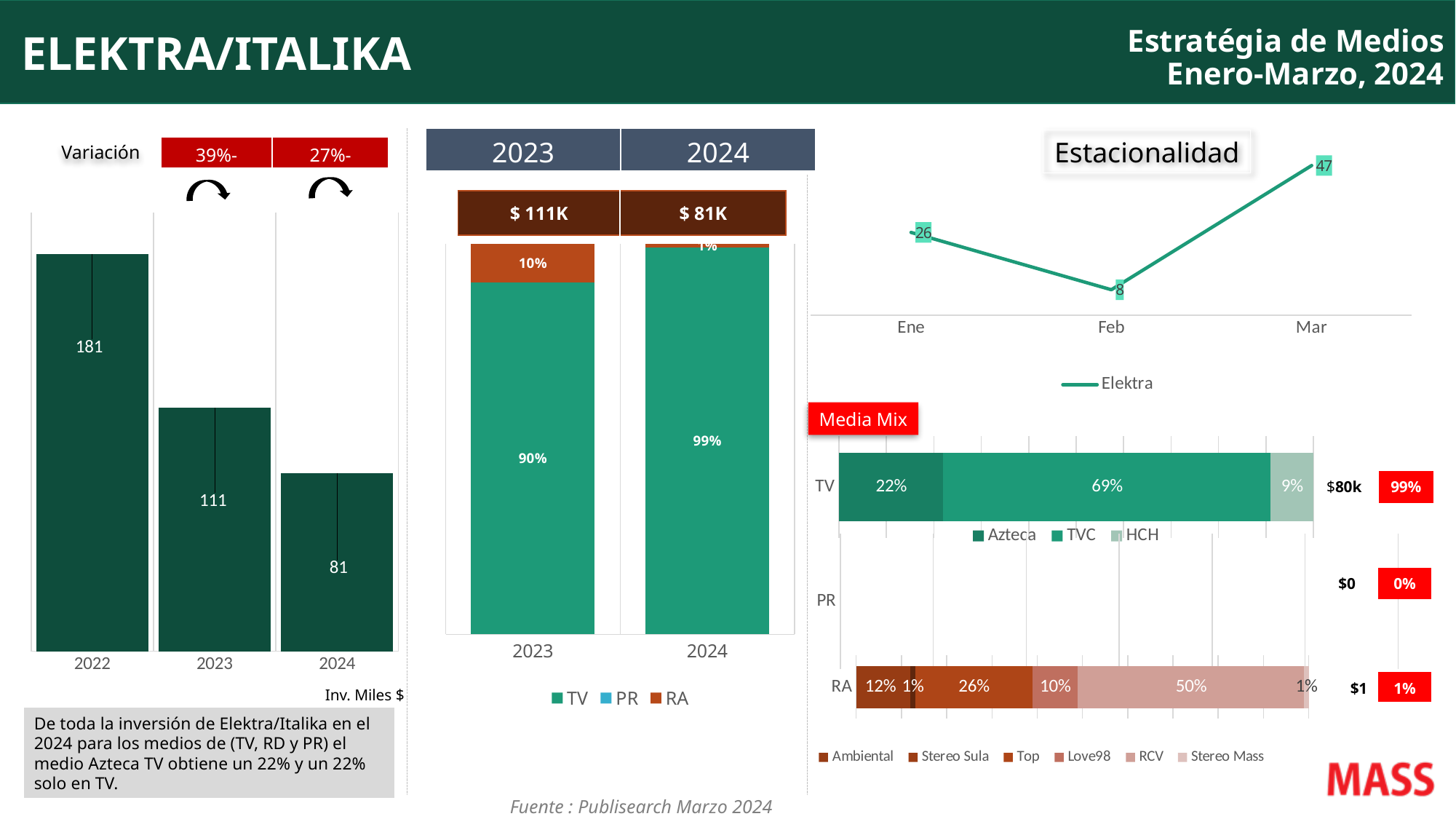
How many series does the legend of the stacked bar chart in the middle of the slide list? 3 In the bar chart on the left of the slide, which year has the highest value? 2022 In the stacked bar chart in the middle of the slide, what share does RA have in 2024? 1% In the bar chart on the left of the slide, what is the value for 2022? 181 In the Media Mix chart, what share does RCV have in the RA bar? 50% In the stacked bar chart in the middle of the slide, what share does TV have in 2023? 90% In the Estacionalidad line chart, what is the difference between the Mar and Ene values? 21 In the bar chart on the left of the slide, what is the difference between the 2022 and 2023 values? 70 In the bar chart on the left of the slide, what is the value for 2024? 81 In the Estacionalidad line chart, what is the value for Feb? 8 In the bar chart on the left of the slide, do the values rise or fall from 2022 to 2024? fall In the Estacionalidad line chart, which month has the highest value? Mar